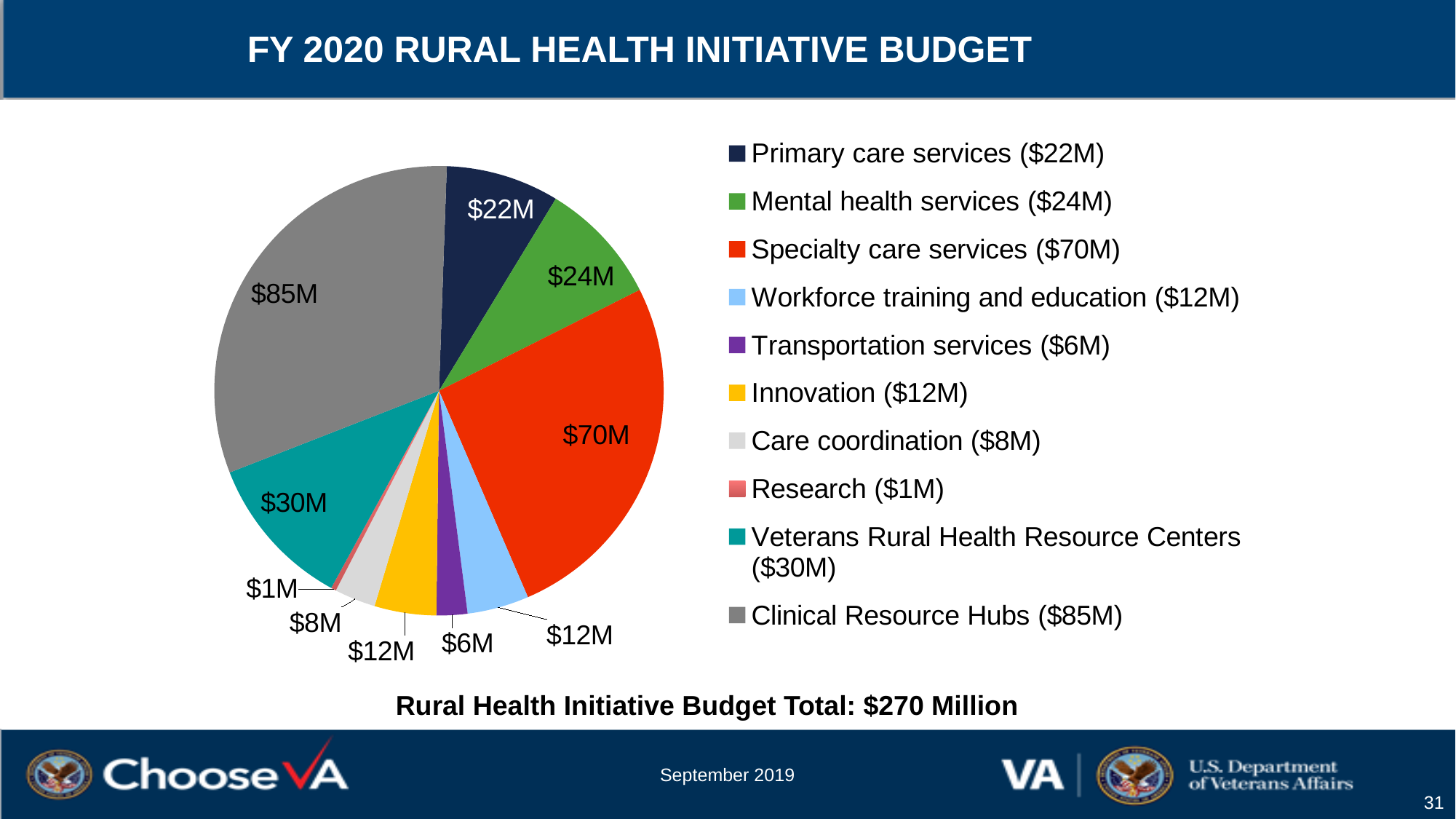
What is the budget value for Transportation services? $6M How many categories are shown in the pie chart? 10 What kind of chart is shown on the slide? Pie chart Which category has the largest slice of the pie? Clinical Resource Hubs Which is larger, the budget for Mental health services or the budget for Primary care services? Mental health services What is the budget value for Veterans Rural Health Resource Centers? $30M What is the title of the slide? FY 2020 RURAL HEALTH INITIATIVE BUDGET What colour is the slice for Innovation? Yellow What is the difference between the Clinical Resource Hubs budget and the Specialty care services budget? $15M Which category has the smallest slice of the pie? Research What is the total Rural Health Initiative Budget shown on the slide? $270 Million What is the budget value for Specialty care services? $70M